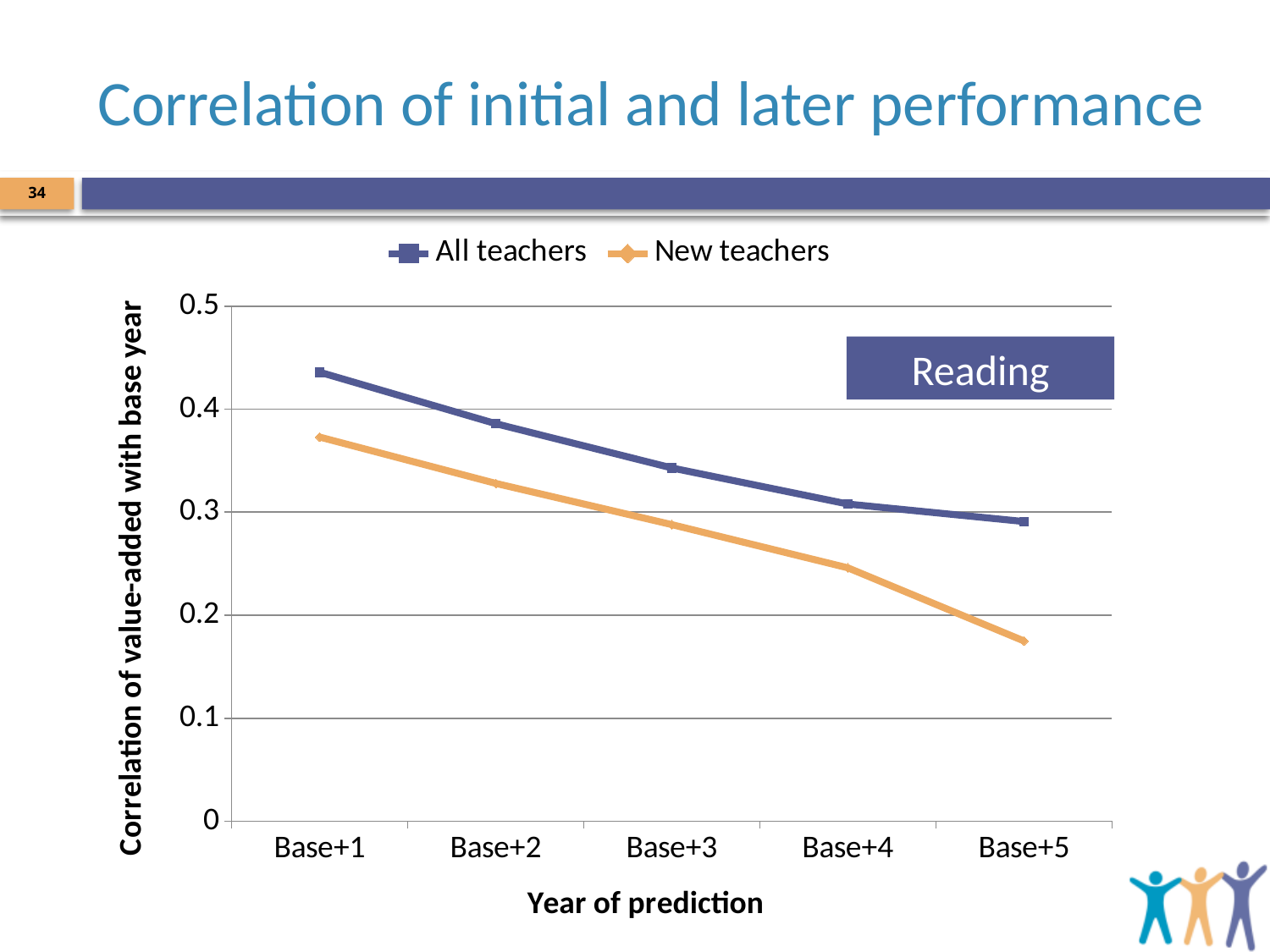
Do the values for New teachers rise or fall from Base+1 to Base+5? fall At Base+5, which series has the larger value, All teachers or New teachers? All teachers How many points are plotted along the x axis for each series? 5 How many series does the legend list? 2 What kind of chart is shown on the slide? line chart Is the value for All teachers at Base+1 greater or less than 0.4? greater Do the values for All teachers rise or fall from Base+1 to Base+5? fall What subject label is shown in the box inside the plot area? Reading At which year of prediction is the All teachers correlation highest? Base+1 At which year of prediction is the New teachers correlation lowest? Base+5 Is the value for New teachers at Base+5 greater or less than 0.2? less Is the value for All teachers at Base+3 greater or less than 0.3? greater